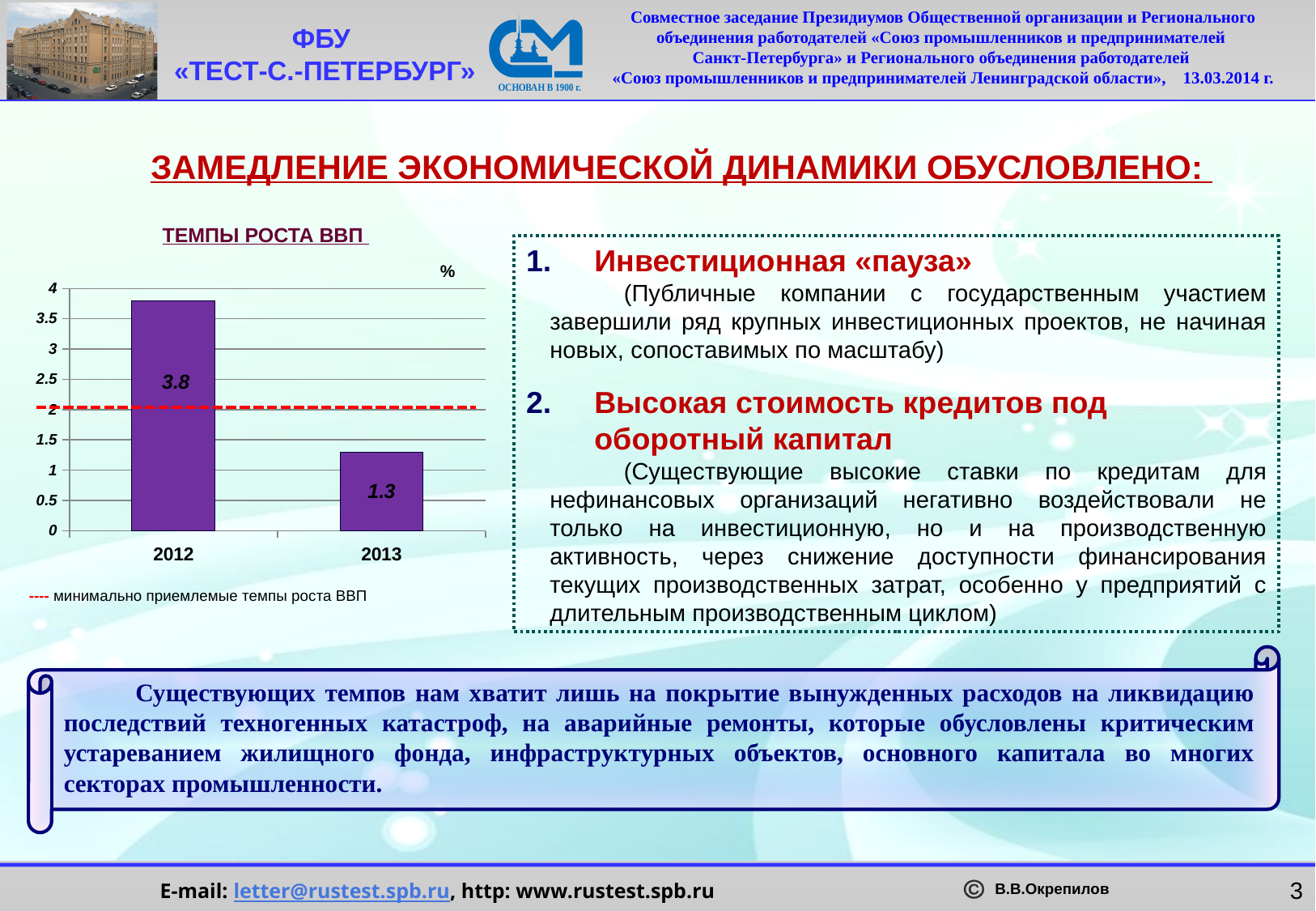
By how much did the GDP growth rate fall from 2012 to 2013 according to the chart? 2.5 Is the value for 2013 greater or less than 2? less What does the red dashed line on the chart represent? минимально приемлемые темпы роста ВВП Which year has the lowest GDP growth rate in the chart? 2013 What is the GDP growth rate shown for 2012 in the chart 'ТЕМПЫ РОСТА ВВП'? 3.8 Do the GDP growth rate values rise or fall from 2012 to 2013? fall What type of chart is used to show the GDP growth rates? bar chart What is the GDP growth rate shown for 2013 in the chart 'ТЕМПЫ РОСТА ВВП'? 1.3 What is the title of the chart on the slide? ТЕМПЫ РОСТА ВВП Which year has the higher GDP growth rate in the chart? 2012 Is the value for 2012 greater or less than 3? greater How many years (bars) are plotted in the chart 'ТЕМПЫ РОСТА ВВП'? 2